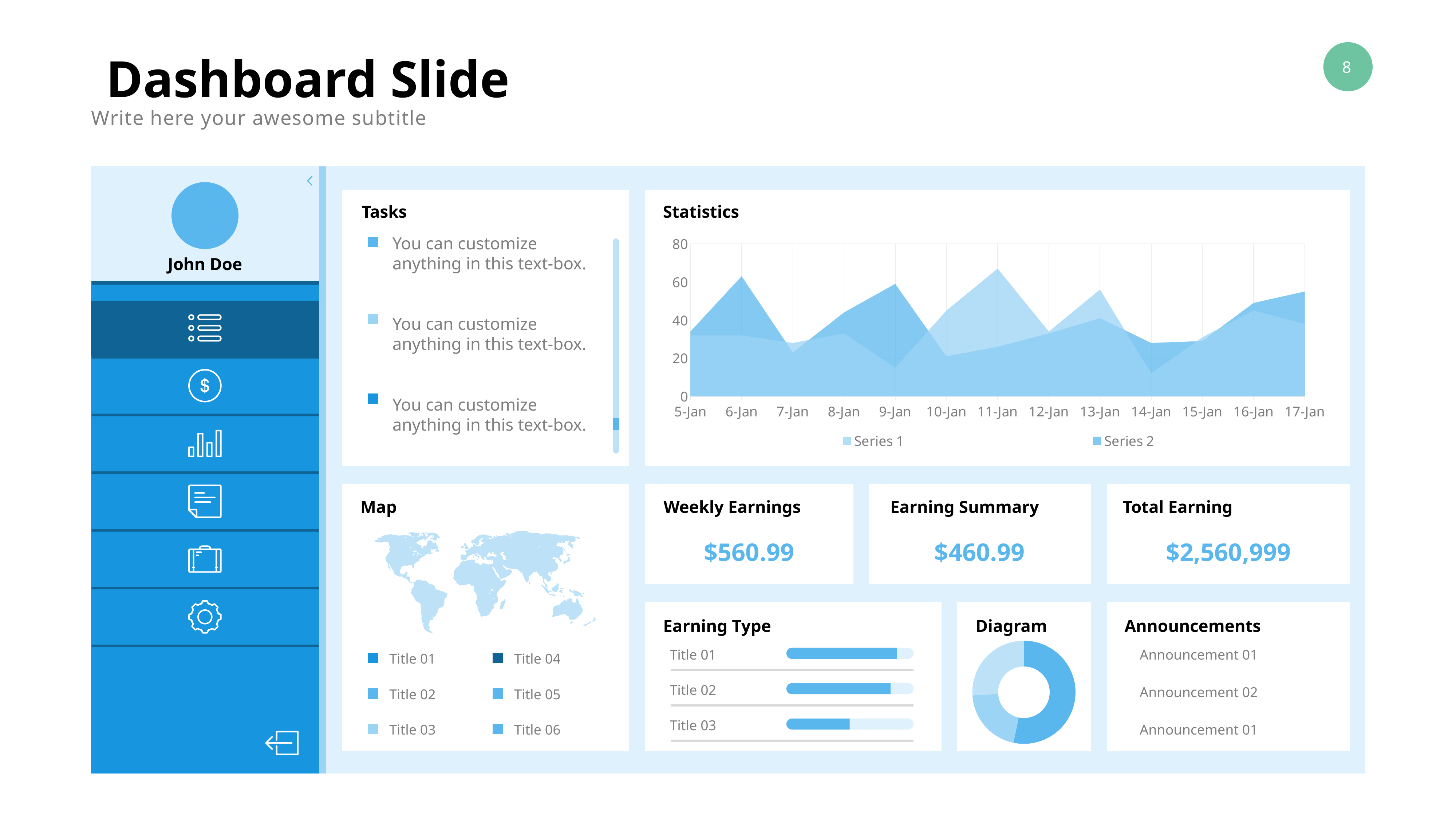
In the Statistics chart, on which date does Series 2 reach its lowest value? 10-Jan In the Statistics chart, which series has the larger value on 6-Jan? Series 2 In the Statistics chart, is the value for Series 2 on 6-Jan greater or less than 40? greater What kind of chart is the Statistics chart? area chart In the Statistics chart, is the value for Series 1 on 9-Jan greater or less than 20? less In the Statistics chart, which series has the larger value on 11-Jan? Series 1 In the Statistics chart, is the value for Series 1 on 11-Jan greater or less than 60? greater In the Statistics chart, on which date does Series 1 reach its highest value? 11-Jan How many series does the legend of the Statistics chart list? 2 How many dates are shown on the x axis of the Statistics chart? 13 What kind of chart is shown in the Diagram panel? doughnut chart